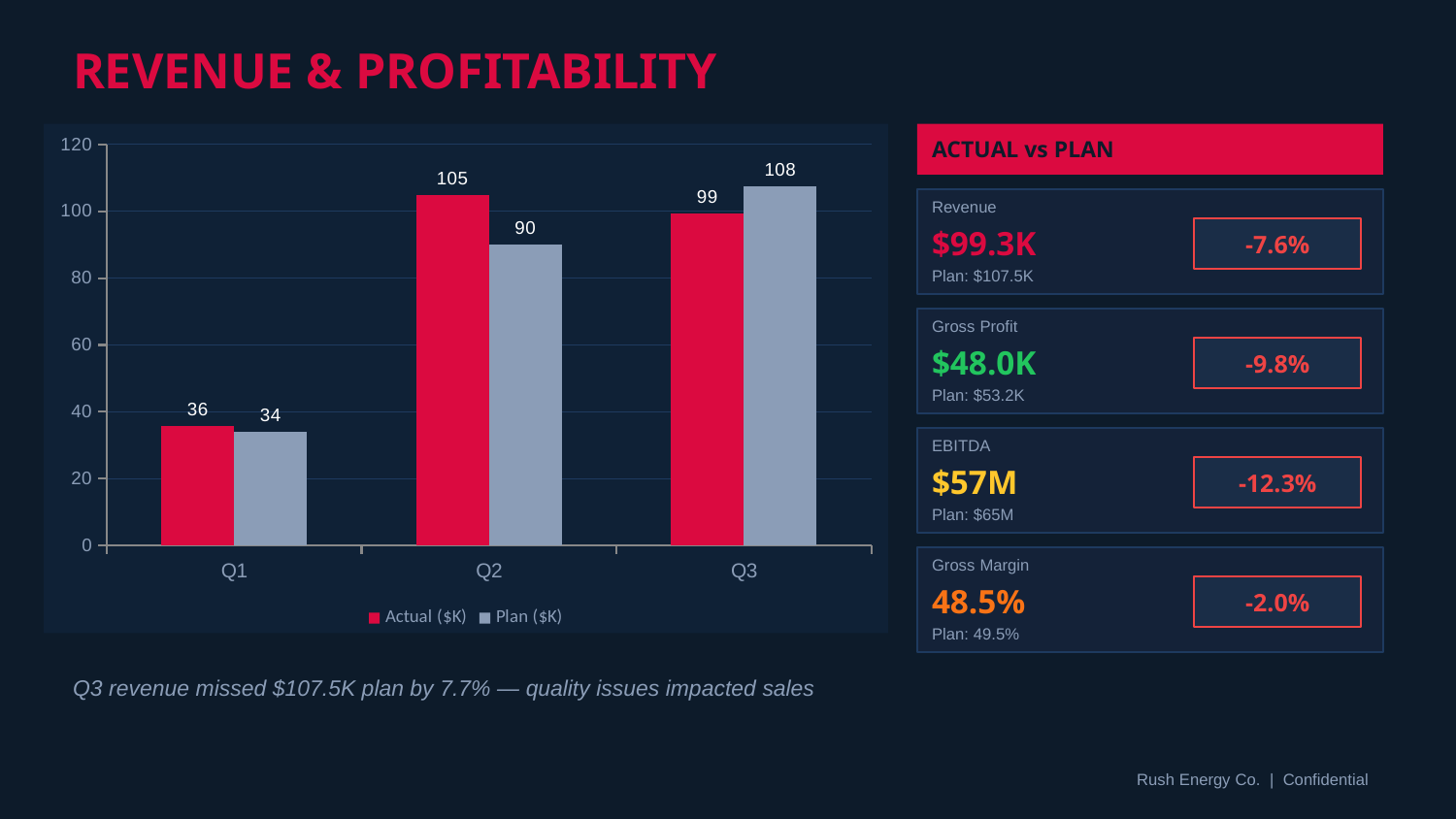
How many quarters are shown on the x axis of the chart? 3 What is the Actual ($K) value for Q1? 36 What is the Plan ($K) value for Q3? 108 Which quarter has the highest Plan ($K) value? Q3 How many series does the chart legend list? 2 What kind of chart is shown on the slide? Bar chart Which is larger for Q1, the Actual ($K) value or the Plan ($K) value? Actual ($K) Which series is shown in red in the chart? Actual ($K) What is the difference between the Actual ($K) and Plan ($K) values for Q2? 15 What is the difference between the Plan ($K) and Actual ($K) values for Q3? 9 Which quarter has the lowest Actual ($K) value? Q1 What is the Actual ($K) value for Q2? 105